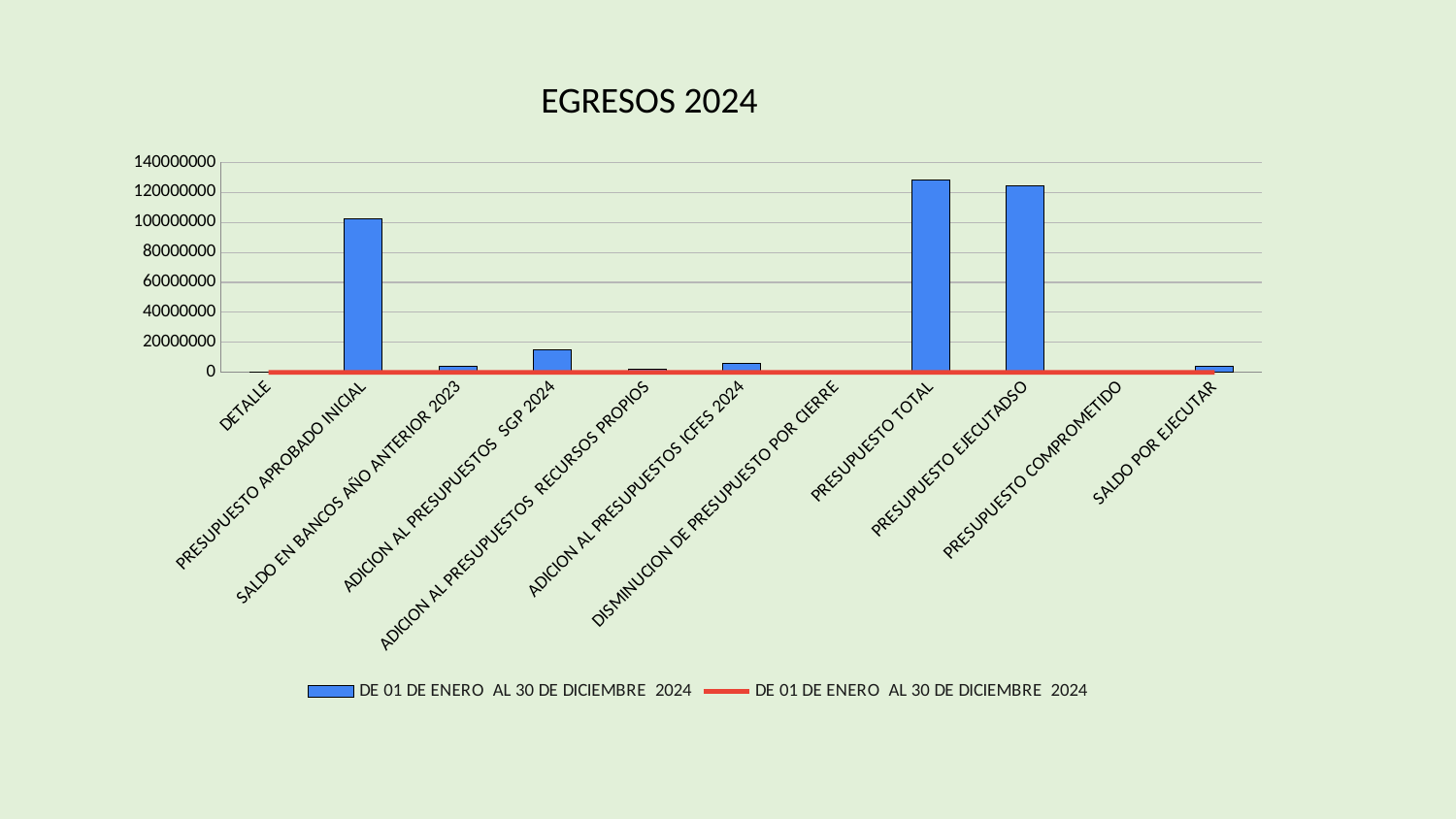
Is the value for PRESUPUESTO APROBADO INICIAL greater or less than 80000000? greater What is the title of the chart? EGRESOS 2024 Is the value for ADICION AL PRESUPUESTOS SGP 2024 greater or less than 20000000? less Which category has the tallest bar in the chart? PRESUPUESTO TOTAL Which is larger, the bar for PRESUPUESTO TOTAL or the bar for PRESUPUESTO APROBADO INICIAL? PRESUPUESTO TOTAL How many categories are shown on the x axis of the chart? 11 What kind of chart is shown on the slide? Combination bar and line chart Is the value for PRESUPUESTO TOTAL greater or less than 120000000? greater How many series does the legend list? 2 Which is larger, the bar for ADICION AL PRESUPUESTOS SGP 2024 or the bar for ADICION AL PRESUPUESTOS ICFES 2024? ADICION AL PRESUPUESTOS SGP 2024